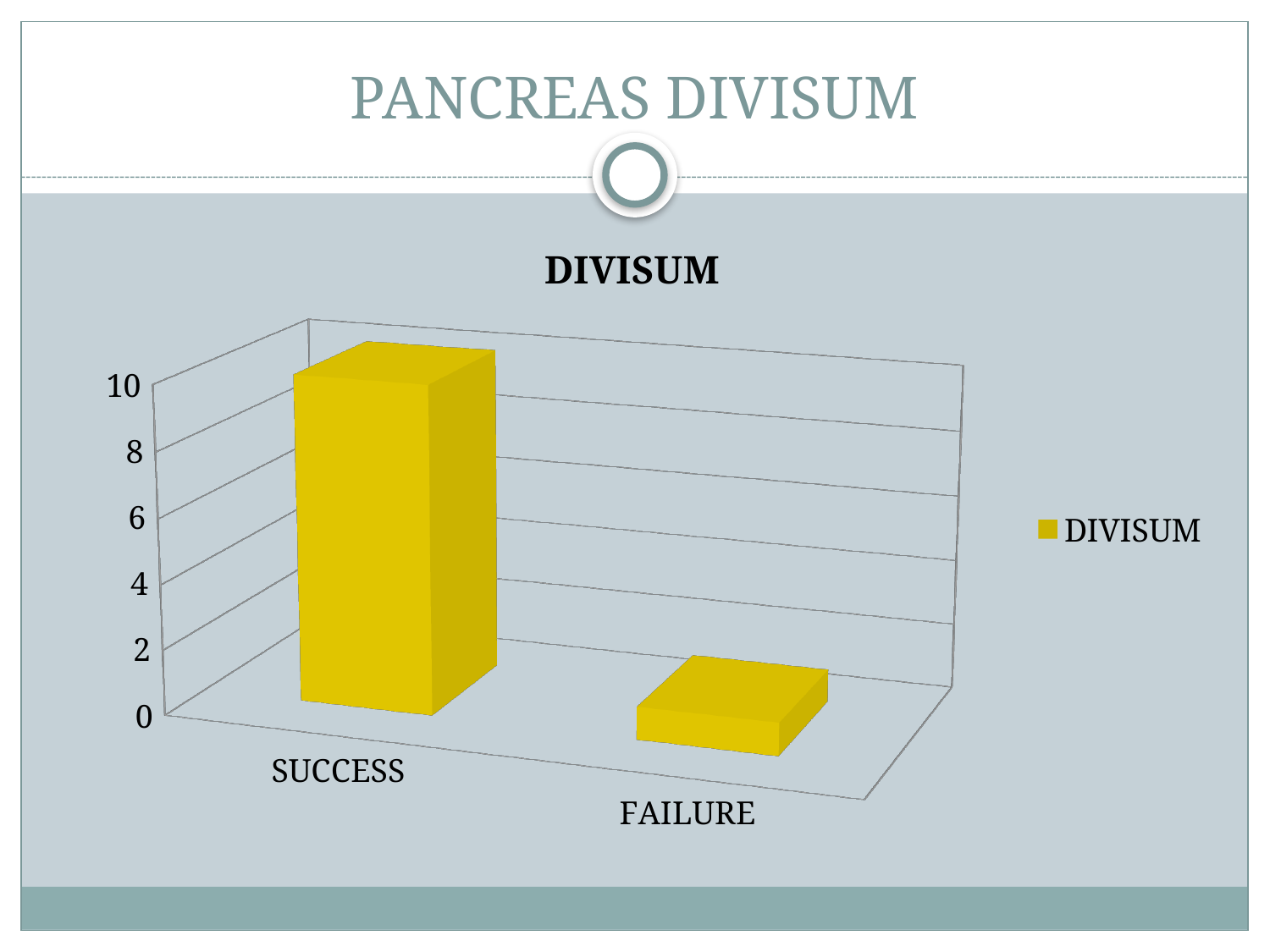
Which category has the lowest value? FAILURE Do the values rise or fall from SUCCESS to FAILURE along the x axis? fall How many categories are shown on the chart's x axis? 2 How many series does the chart's legend list? 1 What is the title of the chart? DIVISUM Is the value for FAILURE greater or less than 4? less Is the value for SUCCESS greater or less than 8? greater Is the value for FAILURE greater or less than 2? less What series name is shown in the chart's legend? DIVISUM Which category has the highest value? SUCCESS What kind of chart is shown on the slide? bar chart Which is larger, the value for SUCCESS or the value for FAILURE? SUCCESS